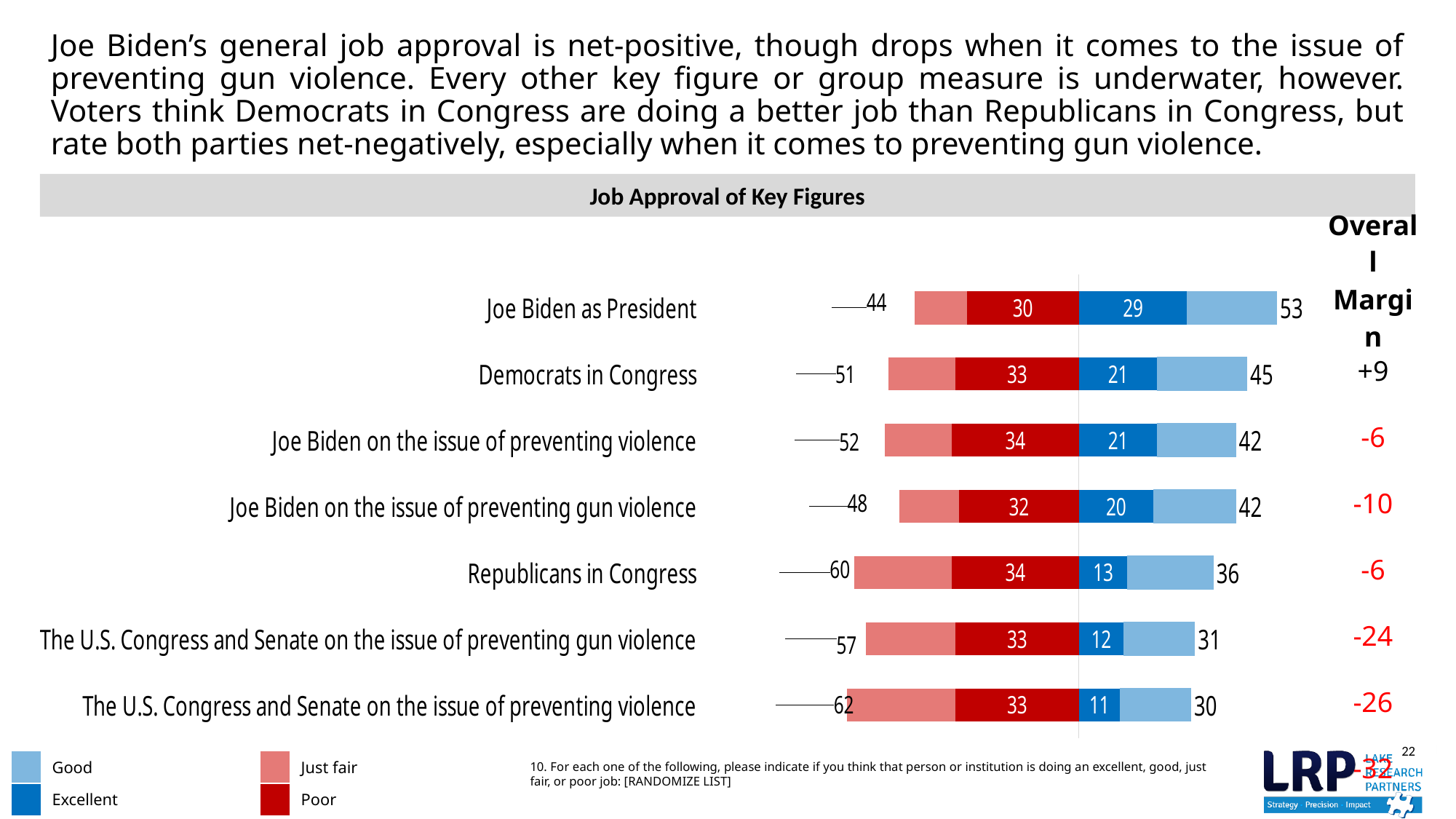
What is the combined Excellent/Good total shown for Republicans in Congress? 36 What kind of chart is shown under the title "Job Approval of Key Figures"? bar chart What is the combined Just fair/Poor total shown for The U.S. Congress and Senate on the issue of preventing violence? 62 What is the difference between the combined Excellent/Good total for Joe Biden as President (53) and for Democrats in Congress (45)? 8 Which has a larger "Excellent" value: Republicans in Congress or Democrats in Congress? Democrats in Congress How many series does the legend list? 4 Which colour represents the "Poor" series in the legend? dark red What is the "Poor" value for Joe Biden on the issue of preventing violence? 34 Which category has the highest "Excellent" value? Joe Biden as President How many key figures or groups are listed as categories in the chart? 7 What is the "Excellent" value for Joe Biden as President? 29 Which category has the lowest combined Excellent/Good total? The U.S. Congress and Senate on the issue of preventing violence